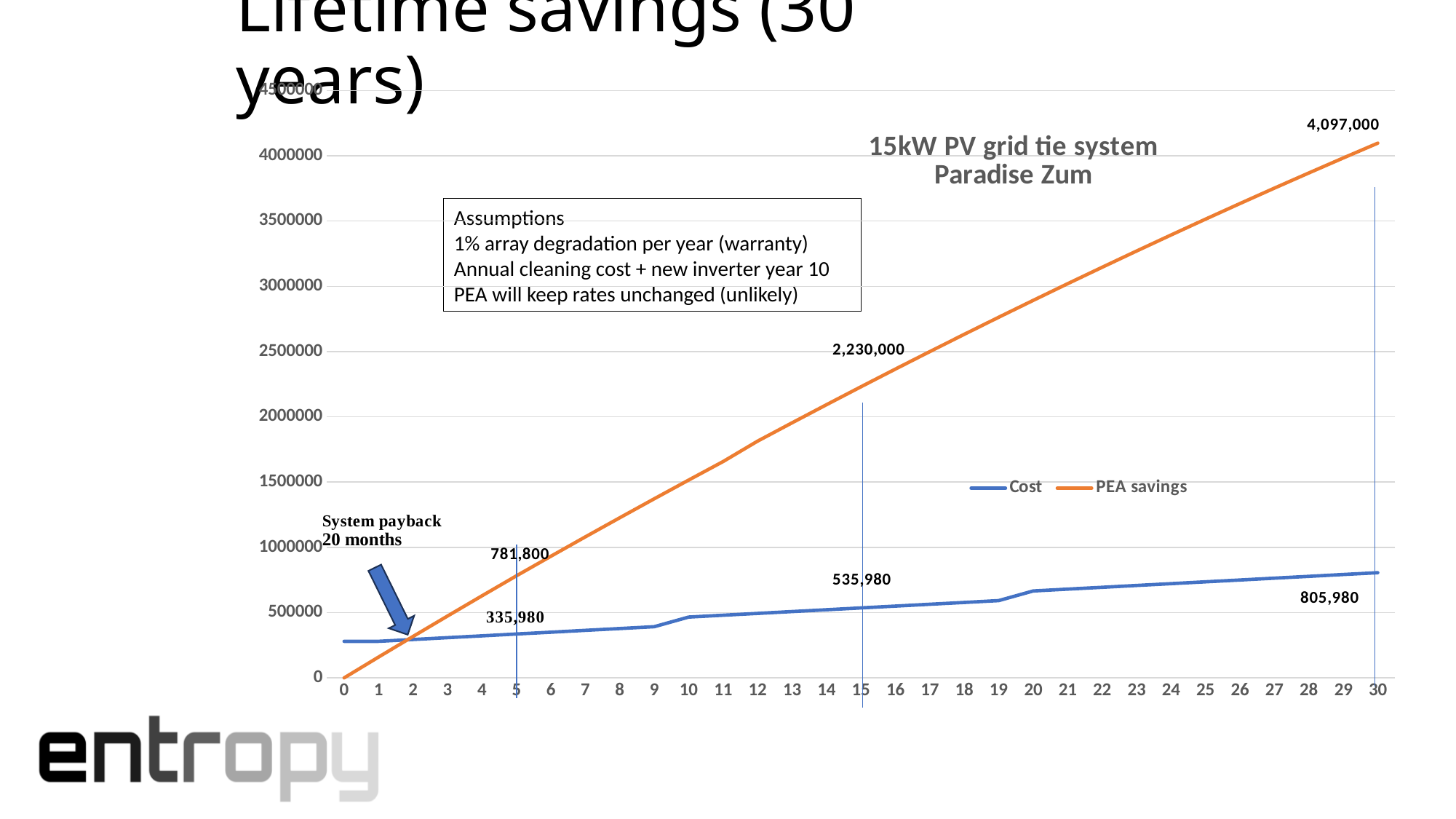
What type of chart is shown on the slide? line chart Is the Cost value at year 20 greater or less than 1000000? less What is the Cost value labelled at year 5? 335,980 What is the title shown inside the chart area? 15kW PV grid tie system Paradise Zum What is the PEA savings value labelled at year 30? 4,097,000 What is the difference between PEA savings and Cost at year 30? 3,291,020 Does the PEA savings line rise or fall as the years increase? rise How many series does the chart legend list? 2 What is the PEA savings value labelled at year 15? 2,230,000 At year 5, which is larger: PEA savings or Cost? PEA savings What is the Cost value labelled at year 30? 805,980 What is the difference between PEA savings and Cost at year 15? 1,694,020